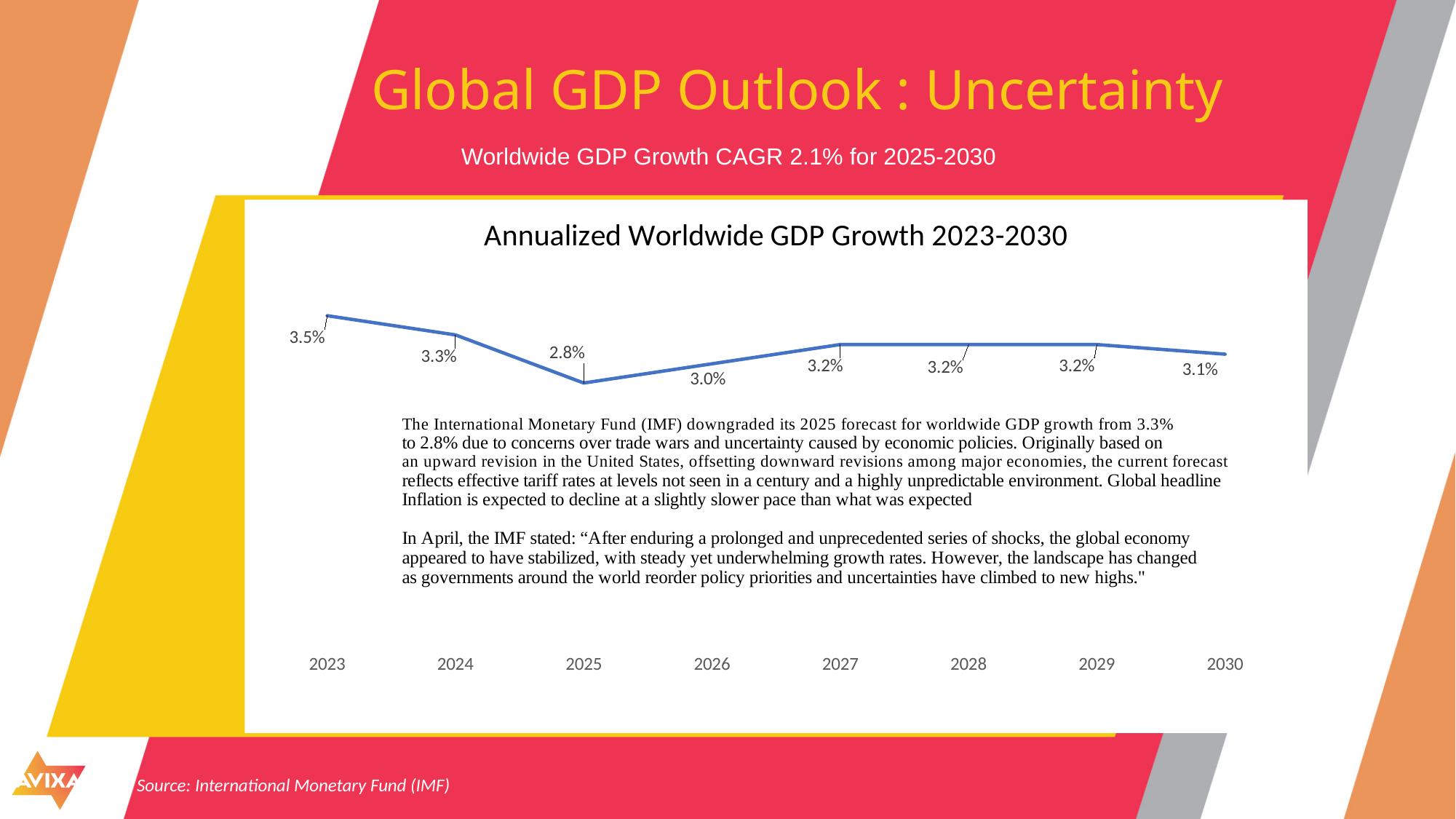
Which year has the highest annualized worldwide GDP growth on the chart? 2023 How many years are plotted on the chart? 8 Does the GDP growth value rise or fall from 2023 to 2025? Fall What is the title of the chart on the slide? Annualized Worldwide GDP Growth 2023-2030 What is the annualized worldwide GDP growth value shown for 2026? 3.0% What is the annualized worldwide GDP growth value shown for 2023? 3.5% What kind of chart is used to show annualized worldwide GDP growth? Line chart What is the annualized worldwide GDP growth value shown for 2025? 2.8% Which year has the larger GDP growth value, 2026 or 2027? 2027 Which year has the lowest annualized worldwide GDP growth on the chart? 2025 What is the annualized worldwide GDP growth value shown for 2030? 3.1% What is the difference between the GDP growth values for 2024 and 2025? 0.5%